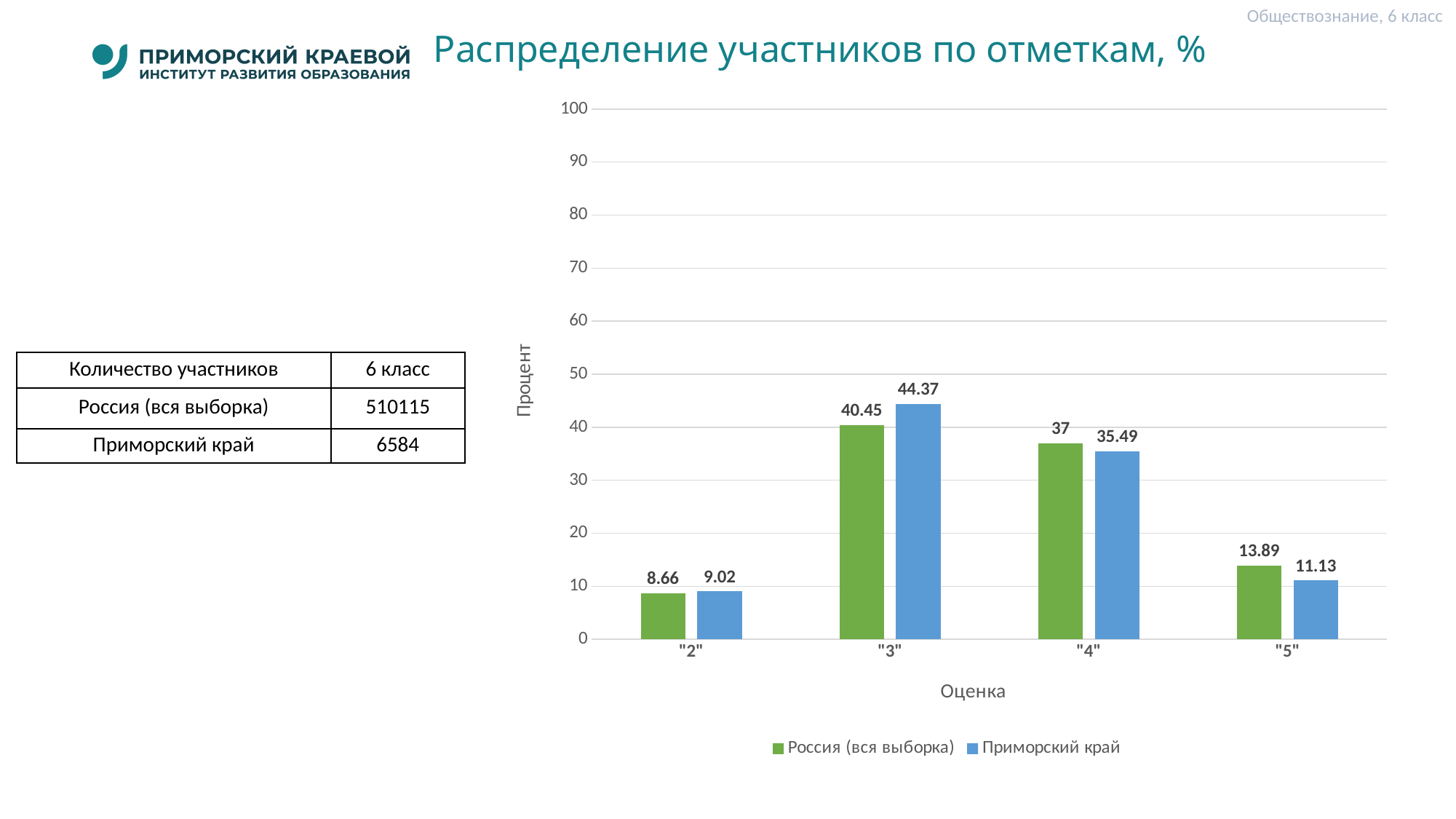
Which grade has the lowest value for Приморский край? "2" How many grade categories are shown on the x axis? 4 How many series does the legend list? 2 What kind of chart is shown on the slide? bar chart Which grade has the highest value for Россия (вся выборка)? "3" Is the value for Приморский край at grade "3" greater or less than 40? greater What is the difference between Приморский край and Россия (вся выборка) at grade "3"? 3.92 What is the label of the y axis? Процент What is the value for Россия (вся выборка) at grade "4"? 37 Which is larger at grade "4": Россия (вся выборка) or Приморский край? Россия (вся выборка) What is the value for Приморский край at grade "3"? 44.37 What is the value for Приморский край at grade "5"? 11.13